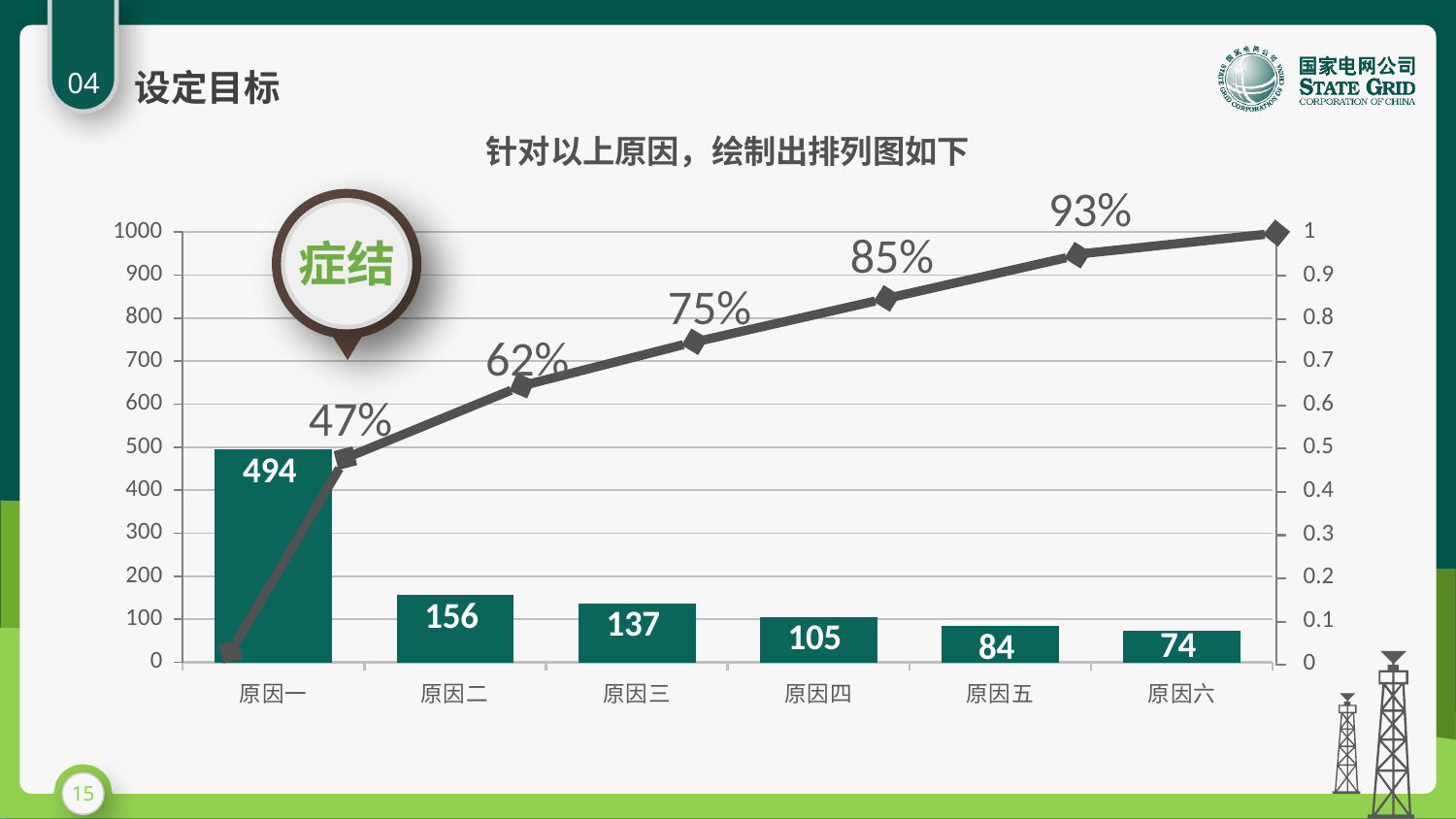
Is the cumulative line value at 原因三 greater or less than 0.7 on the right axis? greater What cumulative percentage is labelled on the line at 原因五? 93% What is the value of the bar for 原因四? 105 What is the difference between the bar values for 原因二 and 原因三? 19 Does the cumulative percentage line rise or fall from 原因一 to 原因六? rises What cumulative percentage is labelled on the line at 原因二? 62% Which bar is larger, 原因四 or 原因五? 原因四 Which category has the lowest bar? 原因六 Which category has the highest bar? 原因一 What is the difference between the bar values for 原因一 and 原因六? 420 How many categories are shown on the x axis? 6 What is the value of the bar for 原因一? 494